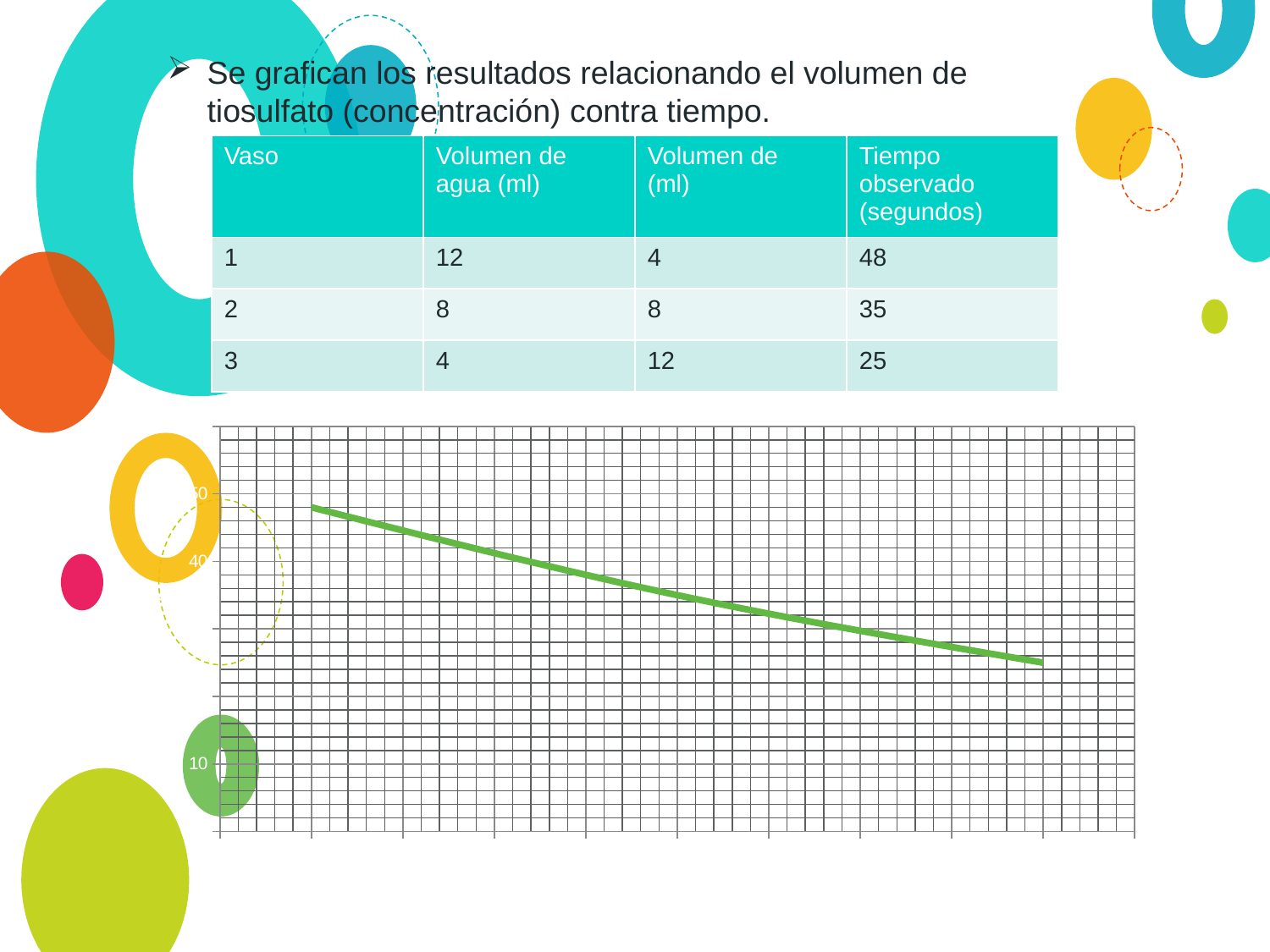
What kind of chart is shown at the bottom of the slide? line chart Is the value at the right end of the plotted line greater or less than 40? less Is the value at the left end of the plotted line greater or less than 40? greater Does the plotted line rise or fall from left to right? fall Is the value at the right end of the plotted line greater or less than 10? greater Which end of the plotted line has the larger value, the left end or the right end? left end What colour is the plotted line on the chart? green